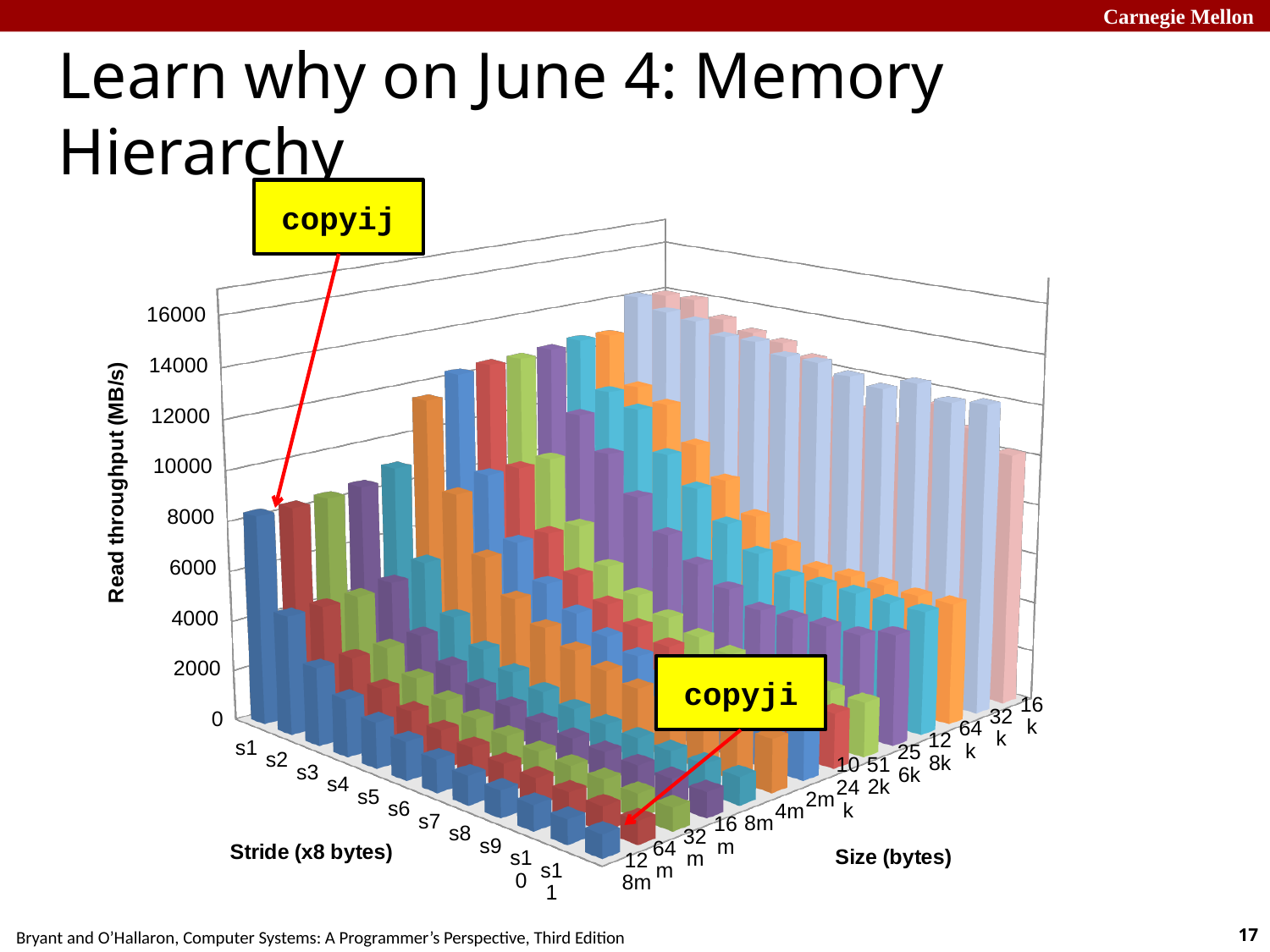
What kind of chart is shown on the slide? 3D bar chart Which stride value has the highest read throughput across the chart? s1 Is the read throughput for stride s1 at size 128m greater or less than 4000? greater Is the read throughput for stride s1 at size 16k greater or less than 12000? greater As stride increases from s1 to s11 for a given size, does read throughput rise or fall? fall What are the two labelled horizontal axes of the chart? Stride (x8 bytes) and Size (bytes) Which has the higher read throughput: stride s1 at size 16k or stride s1 at size 128m? stride s1 at size 16k How many stride categories (s1, s2, ...) are shown along the stride axis? 11 Is the read throughput for stride s11 at size 128m greater or less than 4000? less Which has the higher read throughput: stride s1 at size 128m or stride s11 at size 128m? stride s1 at size 128m What is the highest tick value shown on the read throughput axis? 16000 What is the label of the vertical axis of the chart? Read throughput (MB/s)